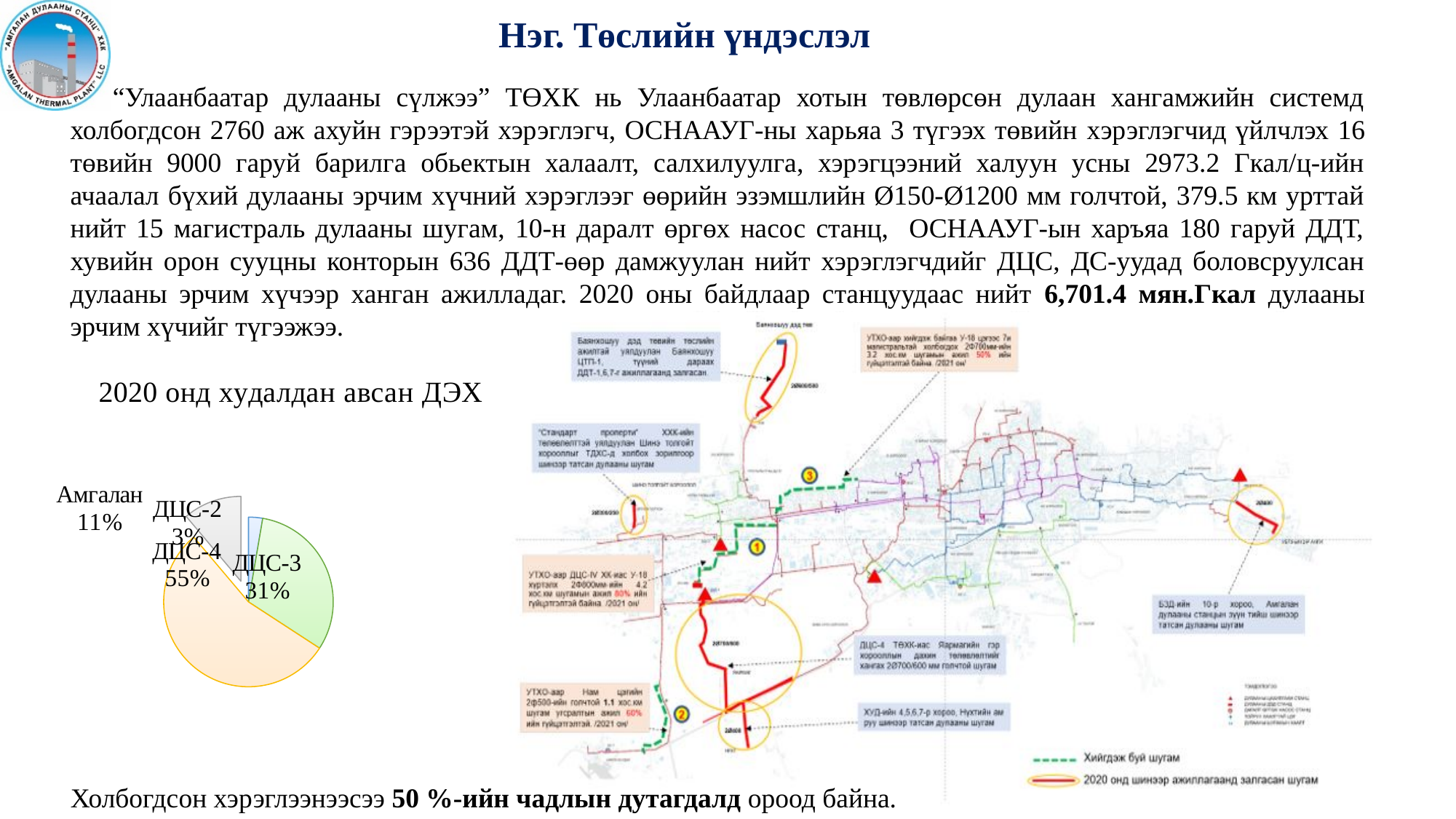
In the pie chart, what share does ДЦС-2 have? 3% What is the title shown above the pie chart? 2020 онд худалдан авсан ДЭХ In the pie chart, what share does Амгалан have? 11% In the pie chart, what is the difference in percentage points between ДЦС-4 and ДЦС-3? 24 What kind of chart is shown under the heading "2020 онд худалдан авсан ДЭХ"? pie chart Which slice of the pie chart is the smallest? ДЦС-2 Which slice of the pie chart is the largest? ДЦС-4 How many slices does the pie chart have? 4 In the pie chart, what is the difference in percentage points between Амгалан and ДЦС-2? 8 In the pie chart, what share does ДЦС-4 have? 55% In the pie chart, what share does ДЦС-3 have? 31% In the pie chart, which is larger: Амгалан or ДЦС-2? Амгалан